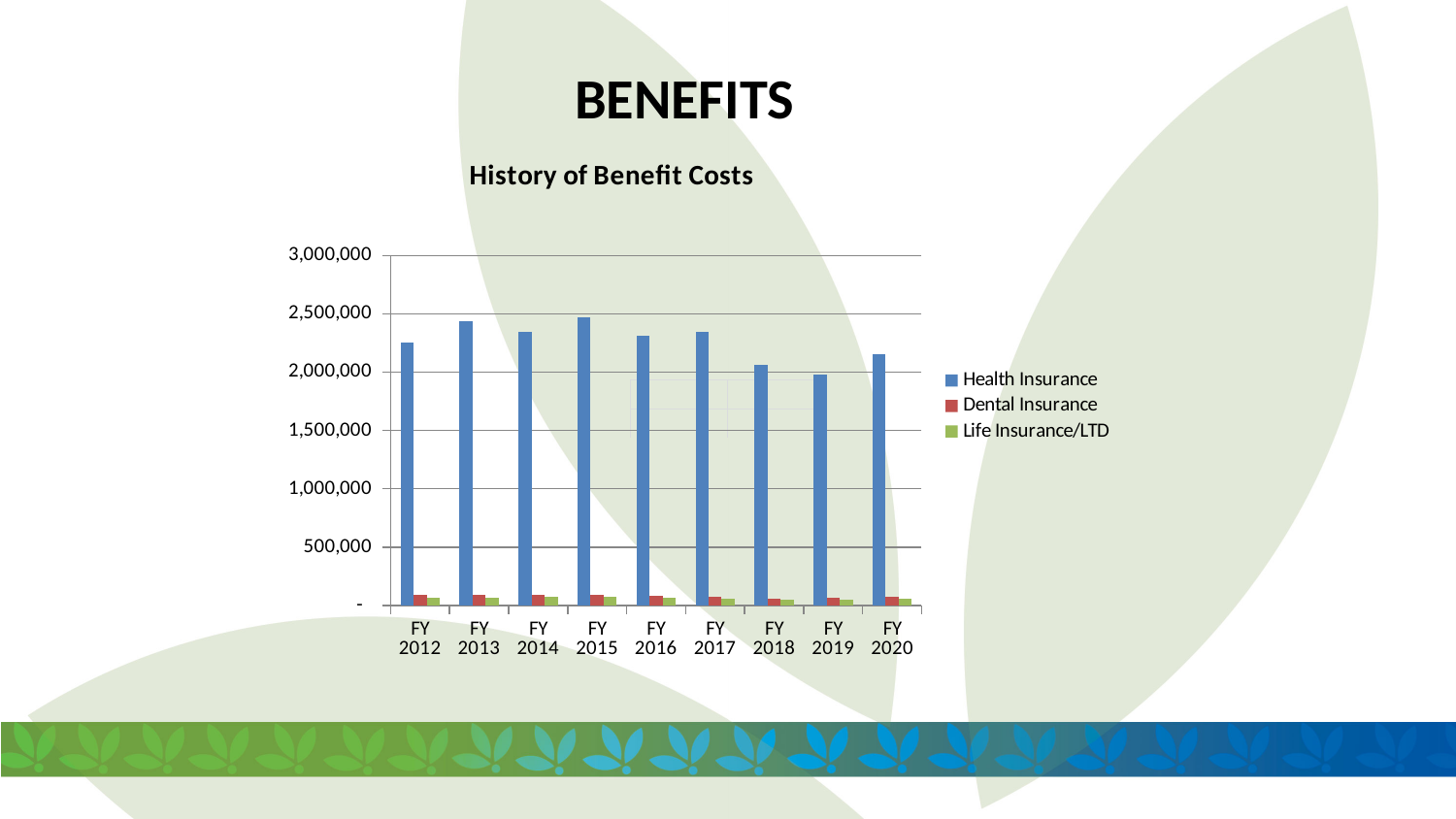
Is the Health Insurance value for FY 2012 greater or less than 2,000,000? greater Is the Dental Insurance value for FY 2015 greater or less than 500,000? less How many series does the legend list? 3 How many fiscal years are shown on the x axis? 9 Which is larger, the Health Insurance cost in FY 2013 or in FY 2018? FY 2013 Is the Health Insurance value for FY 2013 greater or less than 2,500,000? less What is the title of the chart? History of Benefit Costs Does the Health Insurance cost rise or fall from FY 2017 to FY 2019? Fall Which series is shown in blue in the legend? Health Insurance In which fiscal year is the Health Insurance cost lowest? FY 2019 What type of chart is shown on the slide? Bar chart